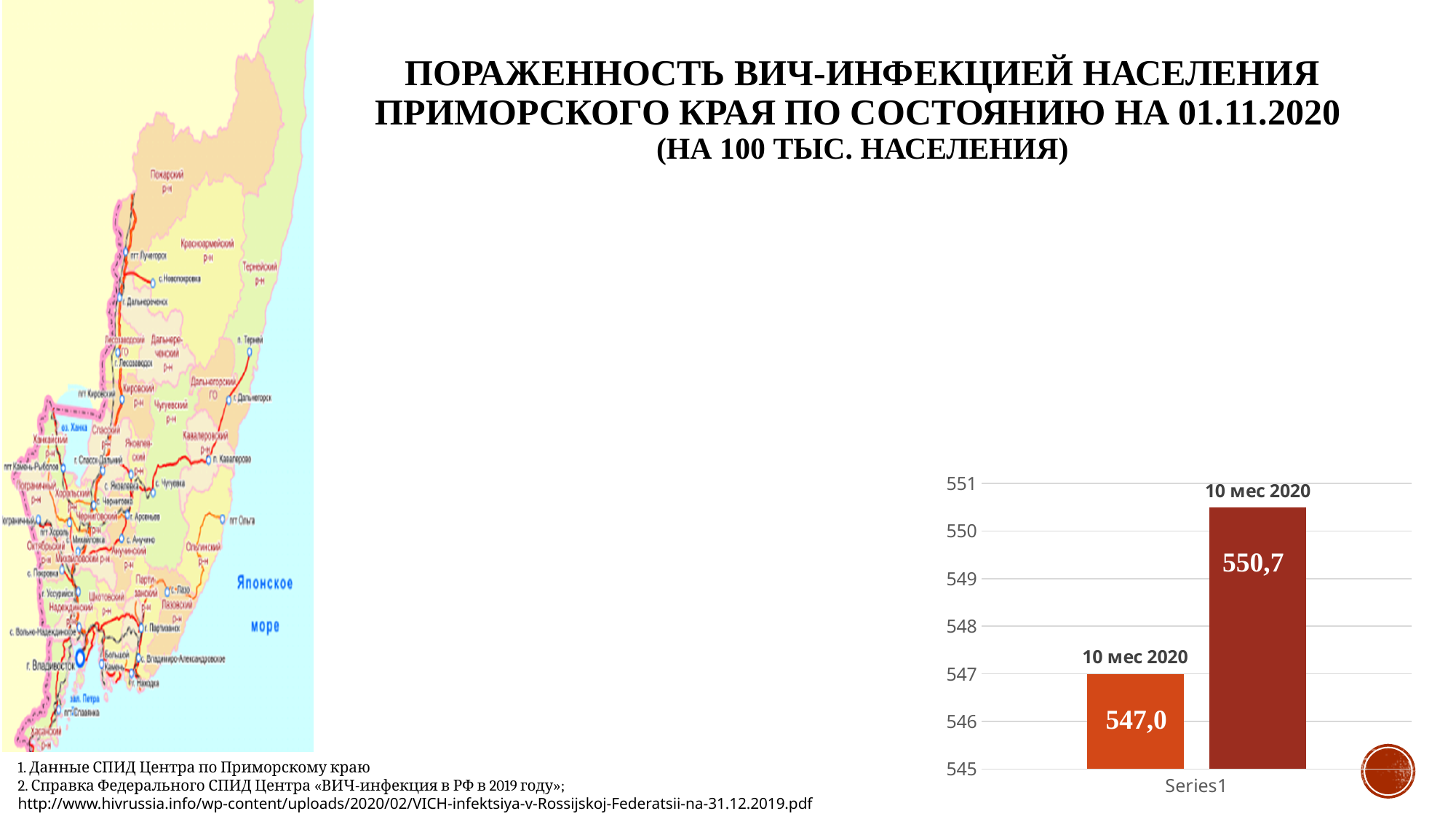
Which bar has the higher value, the orange (left) bar or the dark red (right) bar? the dark red (right) bar What is the highest value plotted in the chart? 550,7 Is the value of the dark red (right) bar greater or less than 550? greater What is the lowest value shown on the vertical axis of the chart? 545 What is the difference between the values of the two bars (550,7 and 547,0)? 3,7 What label appears on the horizontal axis below the bars? Series1 What type of chart is shown on the slide? bar chart What is the lowest value plotted in the chart? 547,0 How many bars are plotted in the chart? 2 Is the value of the orange (left) bar greater or less than 548? less What is the value shown on the orange (left) bar? 547,0 What is the value shown on the dark red (right) bar? 550,7